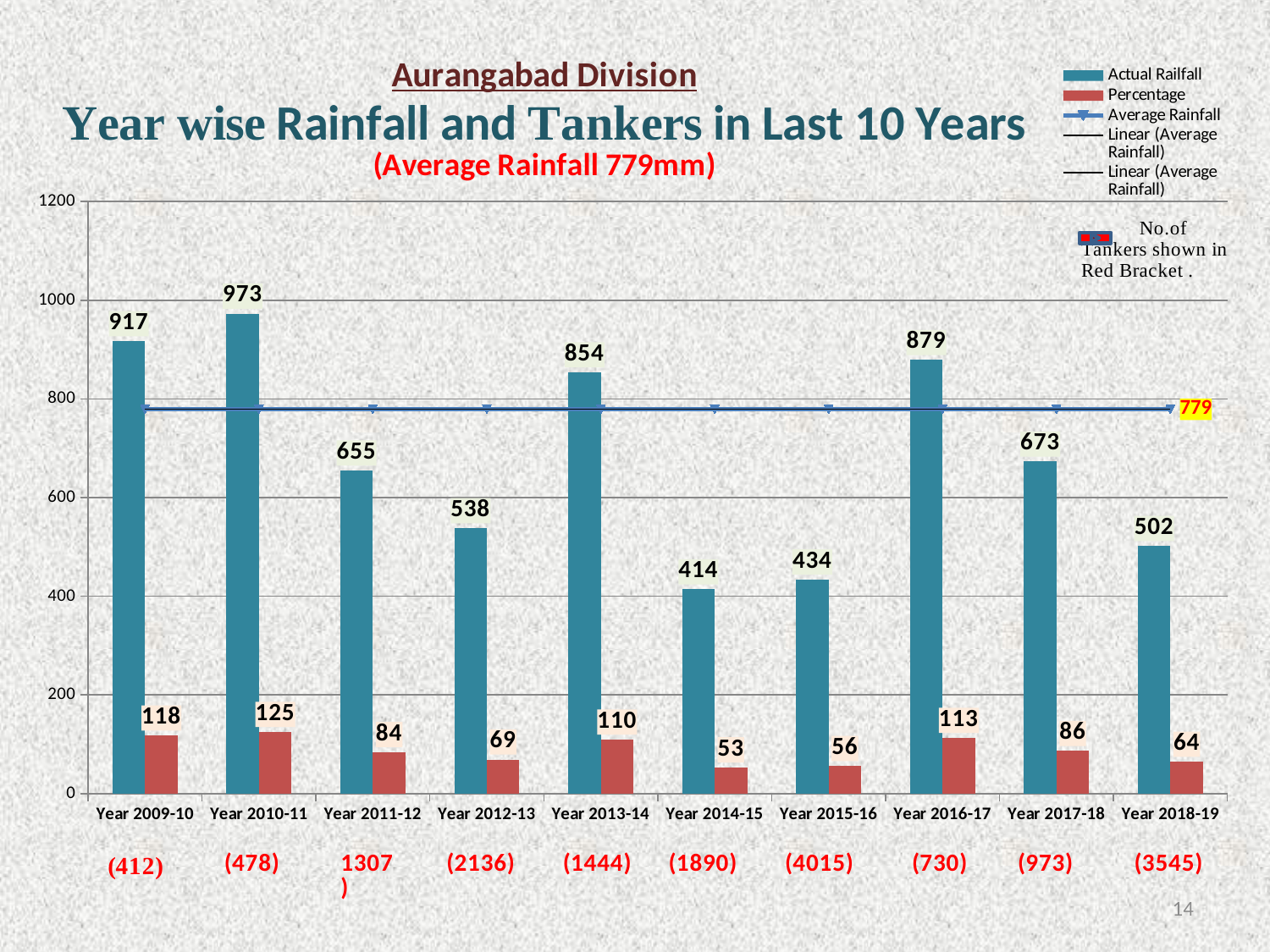
Is the Actual Rainfall for Year 2013-14 greater or less than the Average Rainfall line of 779? greater Which year has the lowest Actual Rainfall? Year 2014-15 What is the difference between the Actual Rainfall for Year 2016-17 and Year 2017-18? 206 What value is labelled on the Average Rainfall line? 779 Which year has the lowest Percentage value? Year 2014-15 What kind of chart is shown on the slide? combination bar and line chart How many years are shown on the x axis? 10 What is the Percentage value for Year 2015-16? 56 What is the Actual Rainfall value for Year 2010-11? 973 Which year has the highest Actual Rainfall? Year 2010-11 How many entries does the legend list? 5 Which is larger, the Actual Rainfall for Year 2012-13 or for Year 2018-19? Year 2012-13